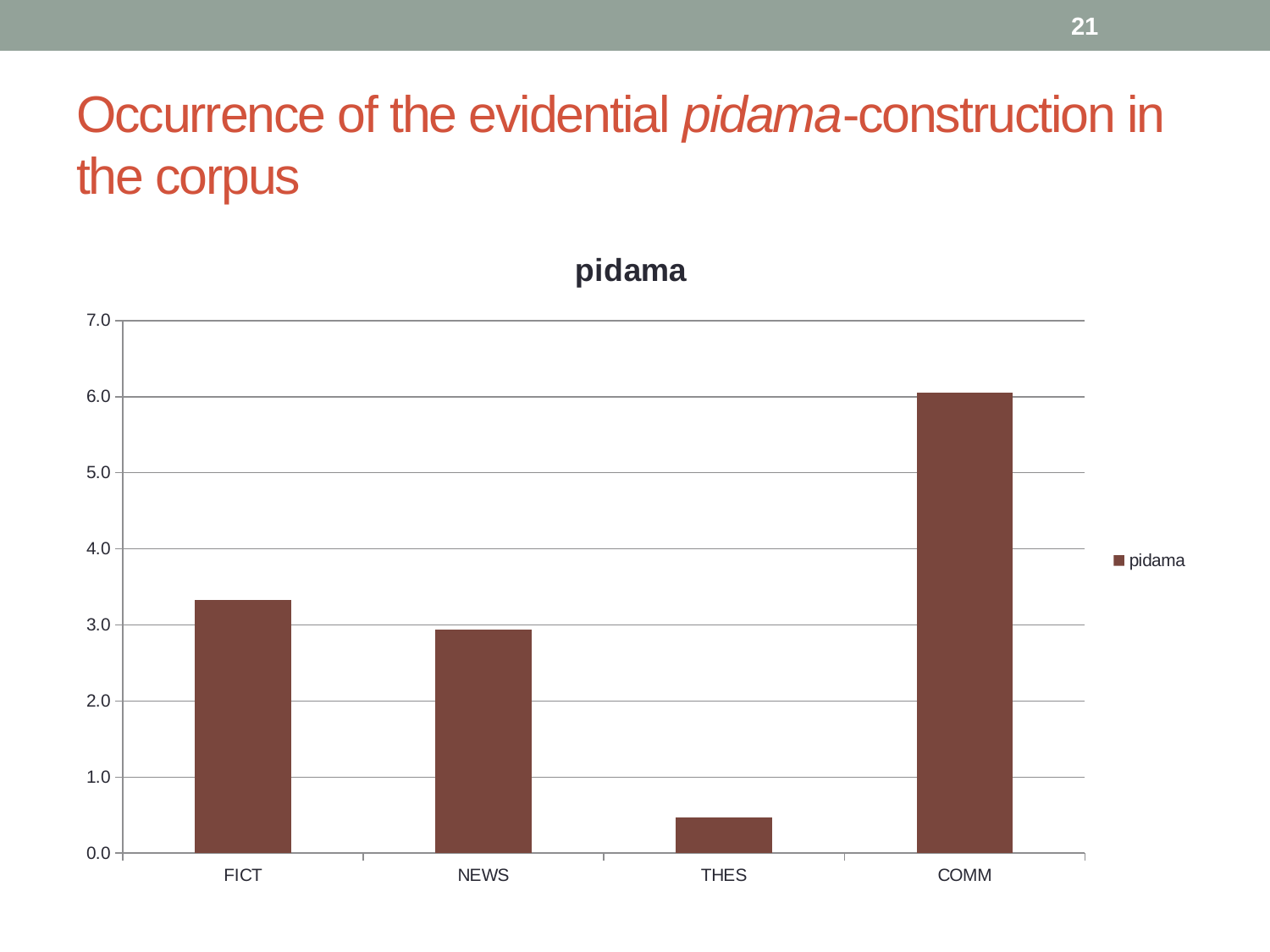
How many series does the legend list? 1 Which category has the highest value in the pidama chart? COMM What is the title of the chart? pidama What kind of chart is shown on the slide? bar chart Is the value for COMM greater or less than 5.0? greater Which is larger, the value for FICT or the value for NEWS? FICT How many categories are shown on the x axis of the chart? 4 Is the value for NEWS greater or less than 2.0? greater Is the value for FICT greater or less than 3.0? greater Which category has the lowest value in the pidama chart? THES Which is larger, the value for THES or the value for COMM? COMM